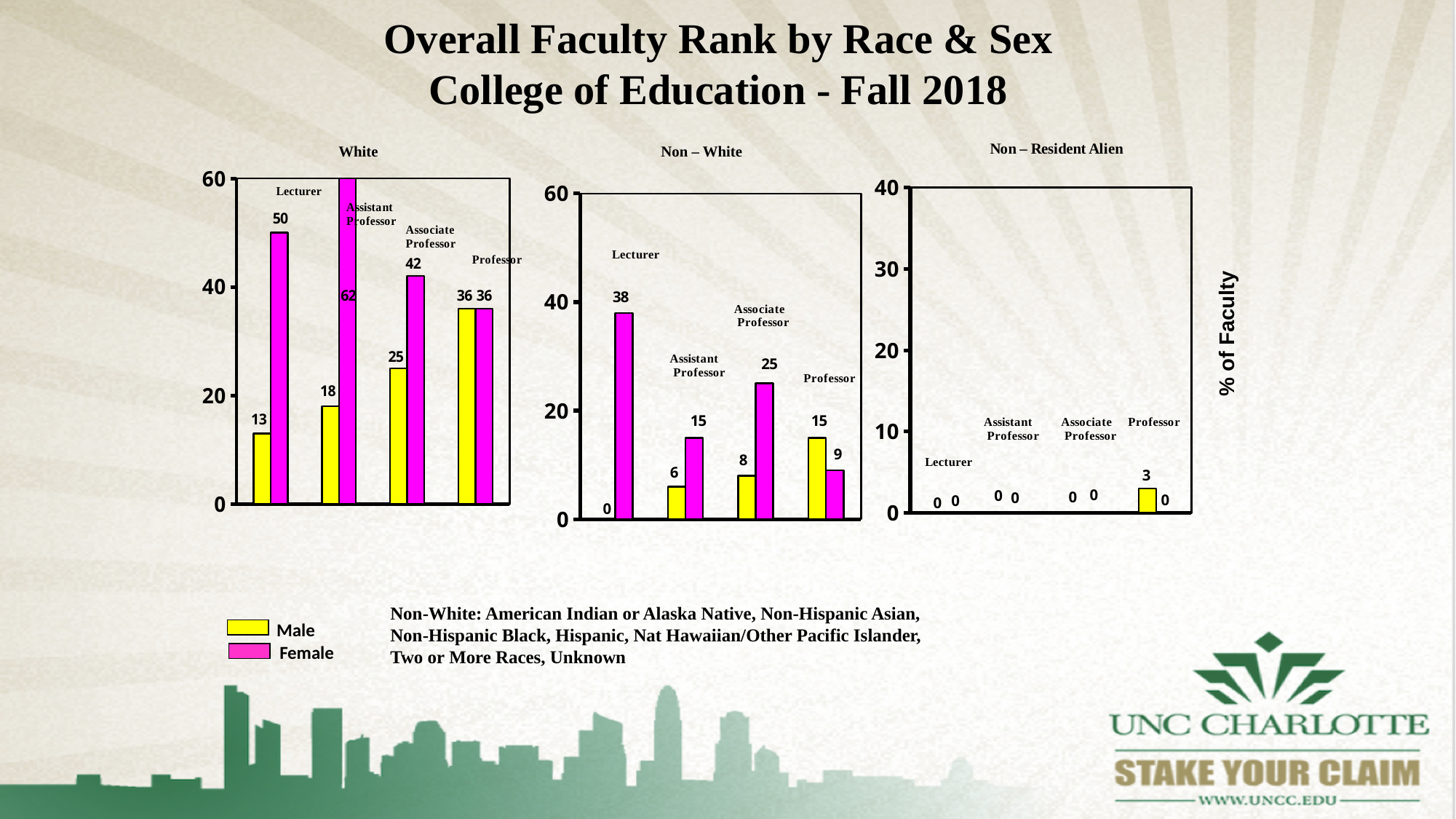
In the White chart, what is the value for Female Lecturer? 50 In the White chart, which rank has the highest Female value? Assistant Professor How many series does the legend list? 2 In the Non – White chart, what is the difference between the Female Lecturer value and the Female Assistant Professor value? 23 In the White chart, what is the value for Male Assistant Professor? 18 What type of chart is the Non – White chart? Bar chart In the Non – White chart, which rank has the lowest Male value? Lecturer In the Non – White chart, which is larger for Professor, the Male value or the Female value? Male In the Non – White chart, what is the value for Female Associate Professor? 25 In the White chart, what is the difference between the Female and Male values for Associate Professor? 17 In the Non – Resident Alien chart, what is the value for Male Professor? 3 How many faculty ranks are shown in the White chart? 4